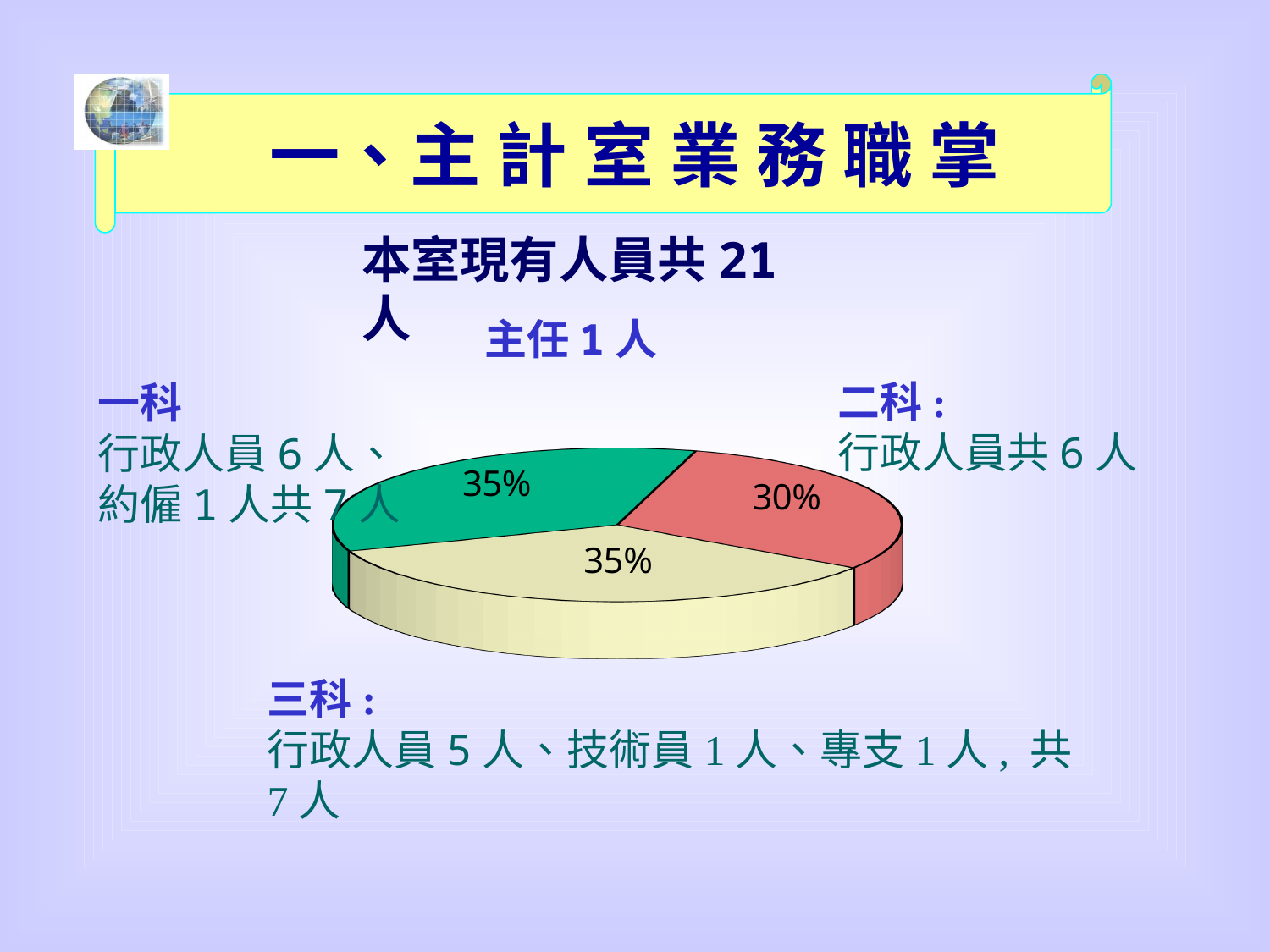
What is the difference in percentage points between the green slice and the red slice? 5 What is the largest percentage shown on the pie chart? 35% Is the value of the red slice greater or less than 35%? less What percentage is shown on the cream-coloured slice of the pie chart? 35% Does the pie chart have a legend? No Which is larger, the green slice or the red slice of the pie chart? green slice What percentage is shown on the red slice of the pie chart? 30% How many slices does the pie chart have? 3 What is the smallest percentage shown on the pie chart? 30% Which colour slice of the pie chart is the smallest? red What kind of chart is shown on the slide? pie chart What percentage is shown on the green slice of the pie chart? 35%